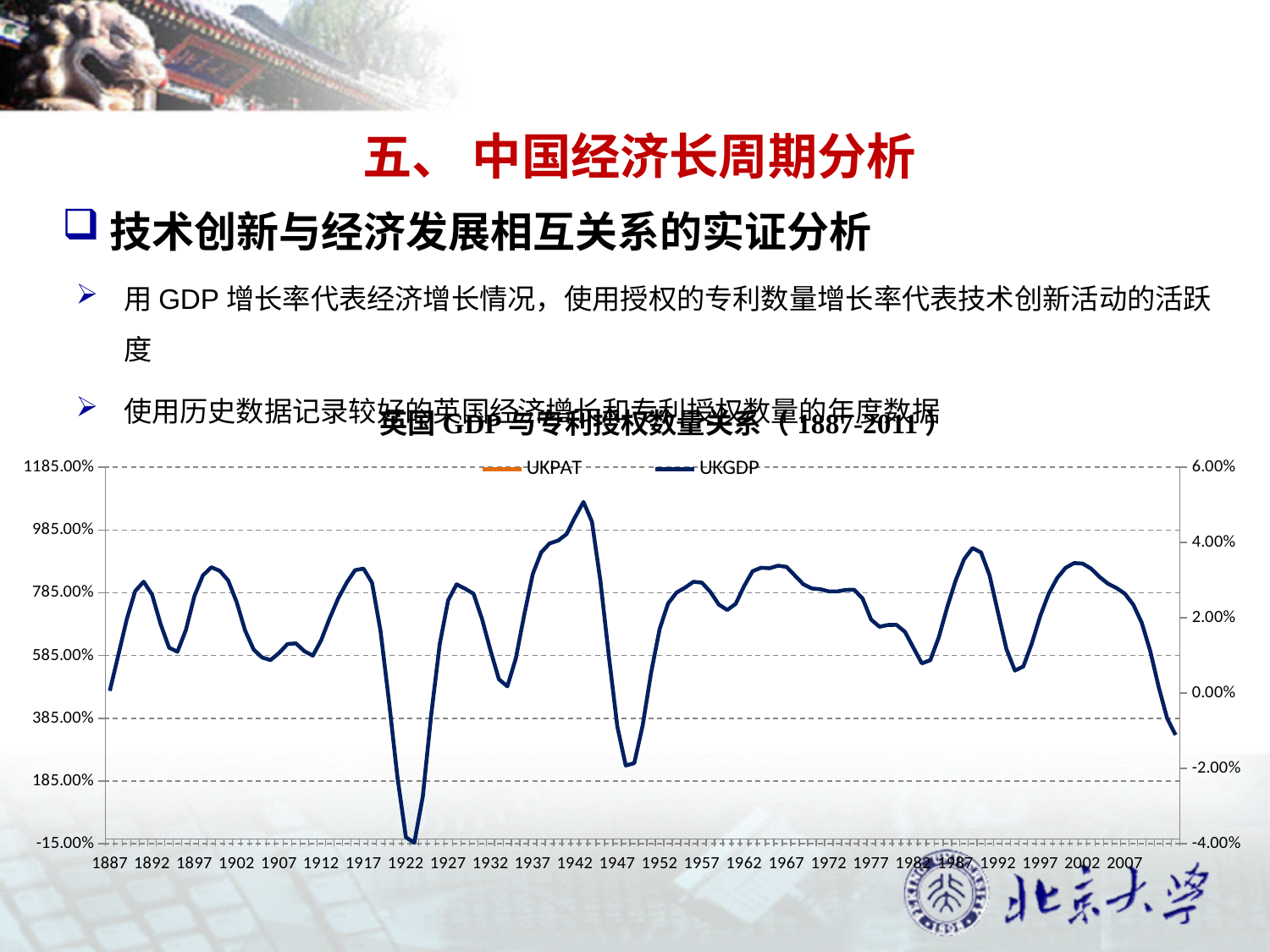
Does the UKGDP line rise or fall between 1942 and 1947? fall Does the UKGDP line rise or fall between 1887 and 1892? rise What is the title of the chart? 英国GDP与专利授权数量关系（1887-2011） What kind of chart is shown on the slide? line chart On the right-hand axis, is the peak UKGDP value around 1942 greater or less than 4.00%? greater On the right-hand axis, is the UKGDP value at the far right end of the line (after 2007) greater or less than 0.00%? less How many year labels are shown along the x axis? 25 On the right-hand axis, is the UKGDP value around 1947 greater or less than 0.00%? less How many series does the chart legend list? 2 Which series is shown in dark blue in the legend? UKGDP